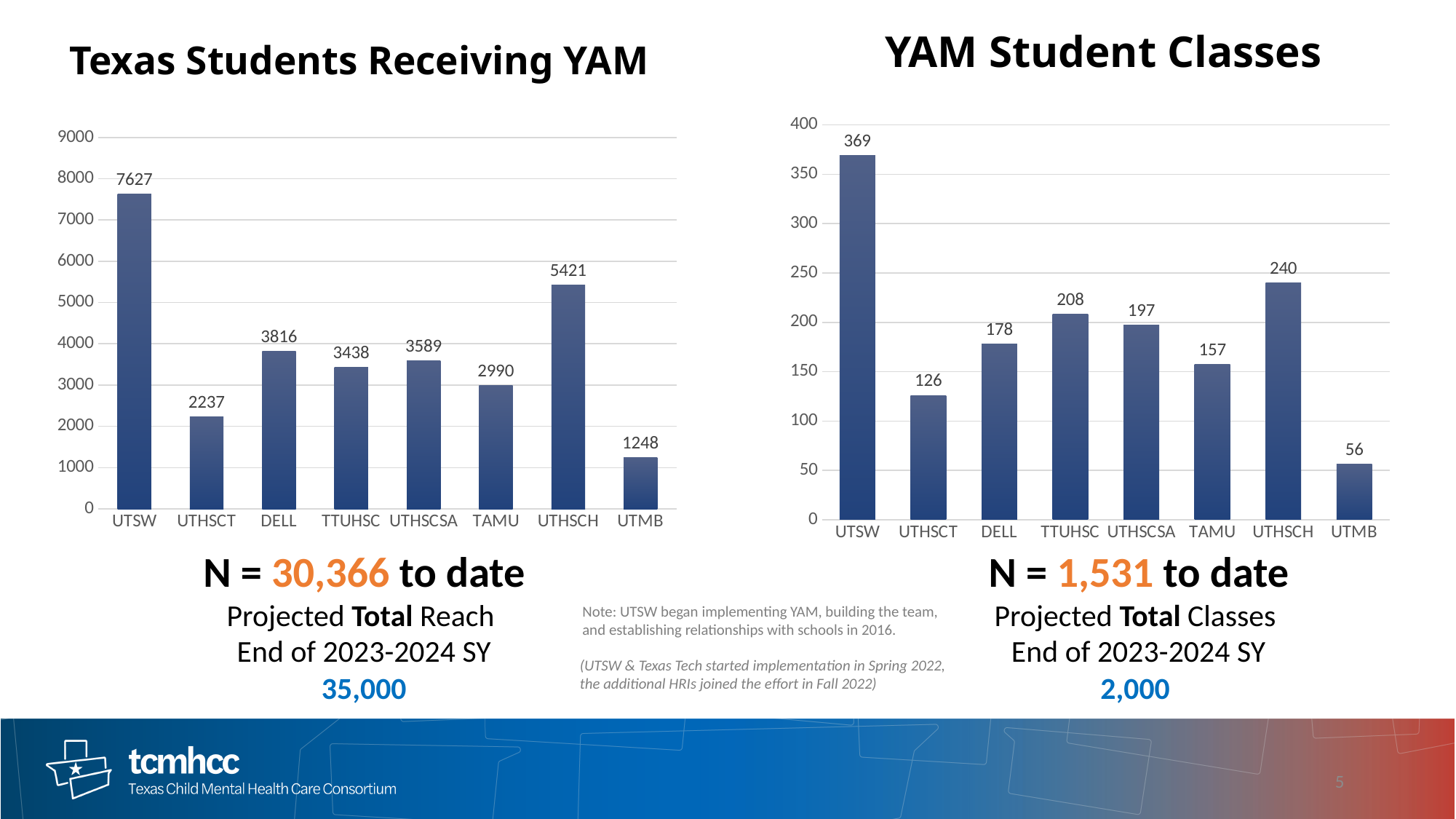
In the 'Texas Students Receiving YAM' chart, what is the difference between the values for UTSW and UTHSCH? 2206 In the 'YAM Student Classes' chart, which category has the highest value? UTSW In the 'YAM Student Classes' chart, is the value for UTHSCT greater or less than 150? less In the 'YAM Student Classes' chart, what is the difference between the values for TTUHSC and UTHSCSA? 11 How many categories are shown in the 'YAM Student Classes' chart? 8 In the 'Texas Students Receiving YAM' chart, what is the value for UTHSCSA? 3589 In the 'Texas Students Receiving YAM' chart, which category has the lowest value? UTMB What kind of chart is the 'Texas Students Receiving YAM' chart? bar chart In the 'Texas Students Receiving YAM' chart, what is the value for UTSW? 7627 In the 'YAM Student Classes' chart, what is the value for UTHSCH? 240 In the 'Texas Students Receiving YAM' chart, which is larger, the value for DELL or the value for TAMU? DELL What is the title of the chart on the right side of the slide? YAM Student Classes